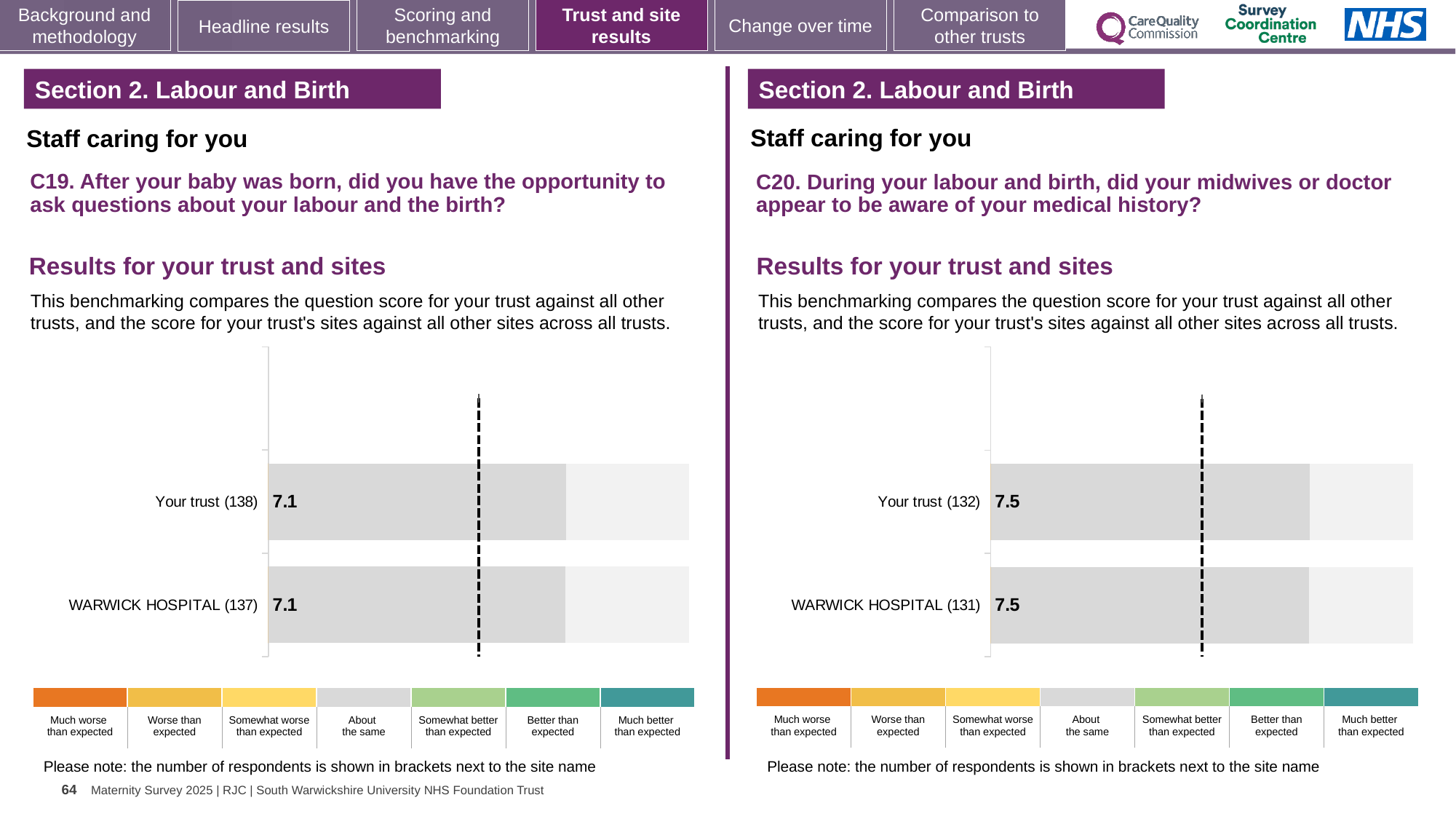
In the C20 chart on the right, what is the difference between the Your trust score and the WARWICK HOSPITAL score? 0.0 How many categories (bars) are plotted in the C20 chart on the right? 2 How many categories (bars) are plotted in the C19 chart on the left? 2 Is the Your trust score in the C20 chart on the right larger or smaller than the Your trust score in the C19 chart on the left? Larger In the C19 chart on the left, what is the score for Your trust? 7.1 What kind of chart is used in the C19 chart on the left? Bar chart In the C20 chart on the right, what is the score for Your trust? 7.5 In the C20 chart on the right, what is the score for WARWICK HOSPITAL? 7.5 In the C19 chart on the left, what is the score for WARWICK HOSPITAL? 7.1 In the C20 chart on the right, how many respondents are shown in brackets for WARWICK HOSPITAL? 131 In the C19 chart on the left, how many respondents are shown in brackets for Your trust? 138 In the C19 chart on the left, what is the difference between the Your trust score and the WARWICK HOSPITAL score? 0.0